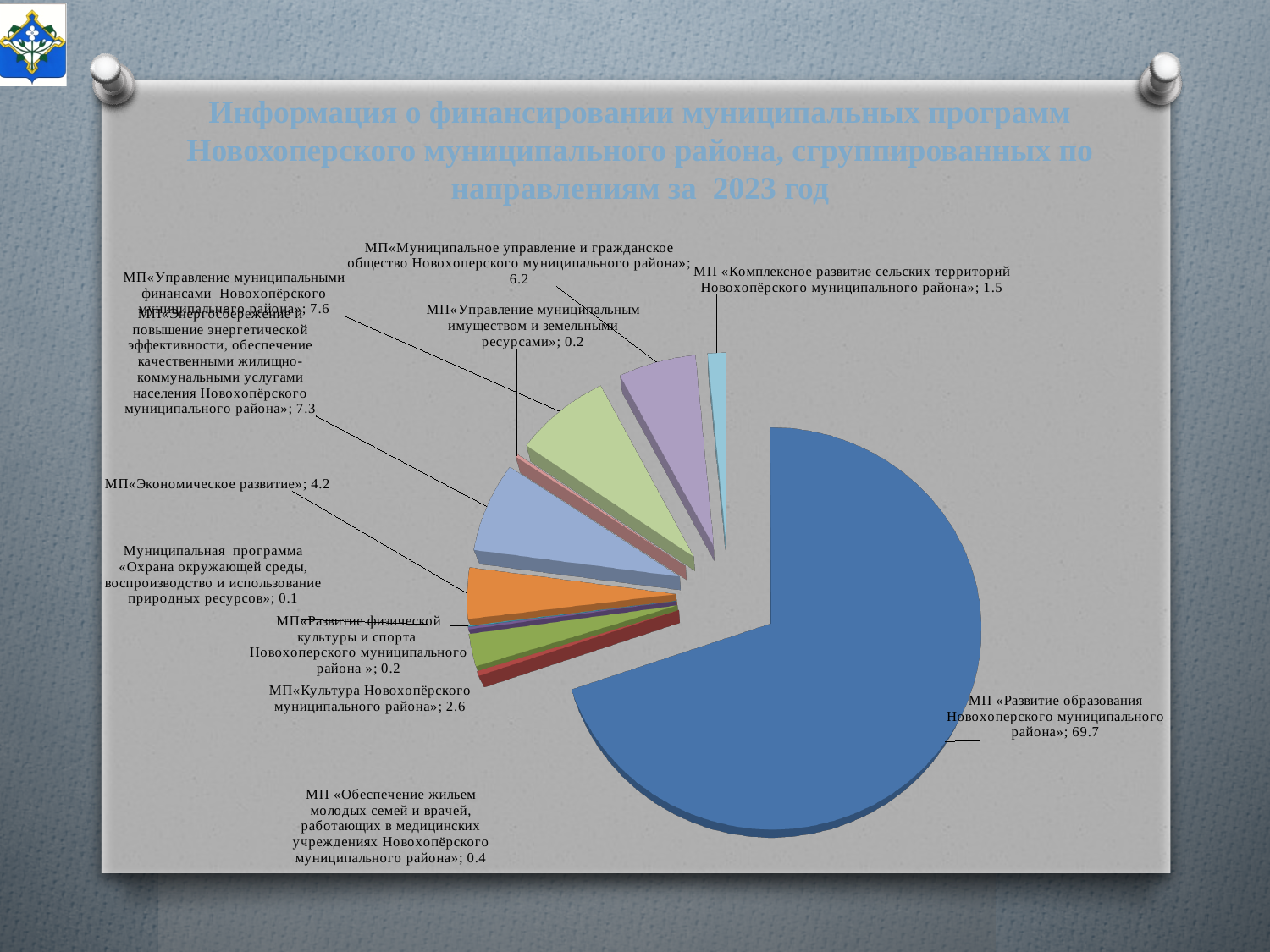
What value is shown for МП «Комплексное развитие сельских территорий Новохопёрского муниципального района»? 1.5 What value is shown for МП «Развитие образования Новохоперского муниципального района»? 69.7 Which municipal programme has the smallest slice of the pie chart? Муниципальная программа «Охрана окружающей среды, воспроизводство и использование природных ресурсов» What value is shown for МП «Обеспечение жильем молодых семей и врачей, работающих в медицинских учреждениях Новохопёрского муниципального района»? 0.4 How many slices (municipal programmes) does the pie chart have? 11 Which has the larger value: МП «Управление муниципальными финансами» or МП «Энергосбережение и повышение энергетической эффективности...»? МП «Управление муниципальными финансами» Which municipal programme has the largest slice of the pie chart? МП «Развитие образования Новохоперского муниципального района» What kind of chart is shown on the slide? pie chart What value is shown for МП «Культура Новохопёрского муниципального района»? 2.6 Which year does the chart title say the financing information refers to? 2023 What is the difference between the values for МП «Муниципальное управление и гражданское общество» (6.2) and МП «Экономическое развитие» (4.2)? 2 What value is shown for МП «Управление муниципальными финансами Новохопёрского муниципального района»? 7.6